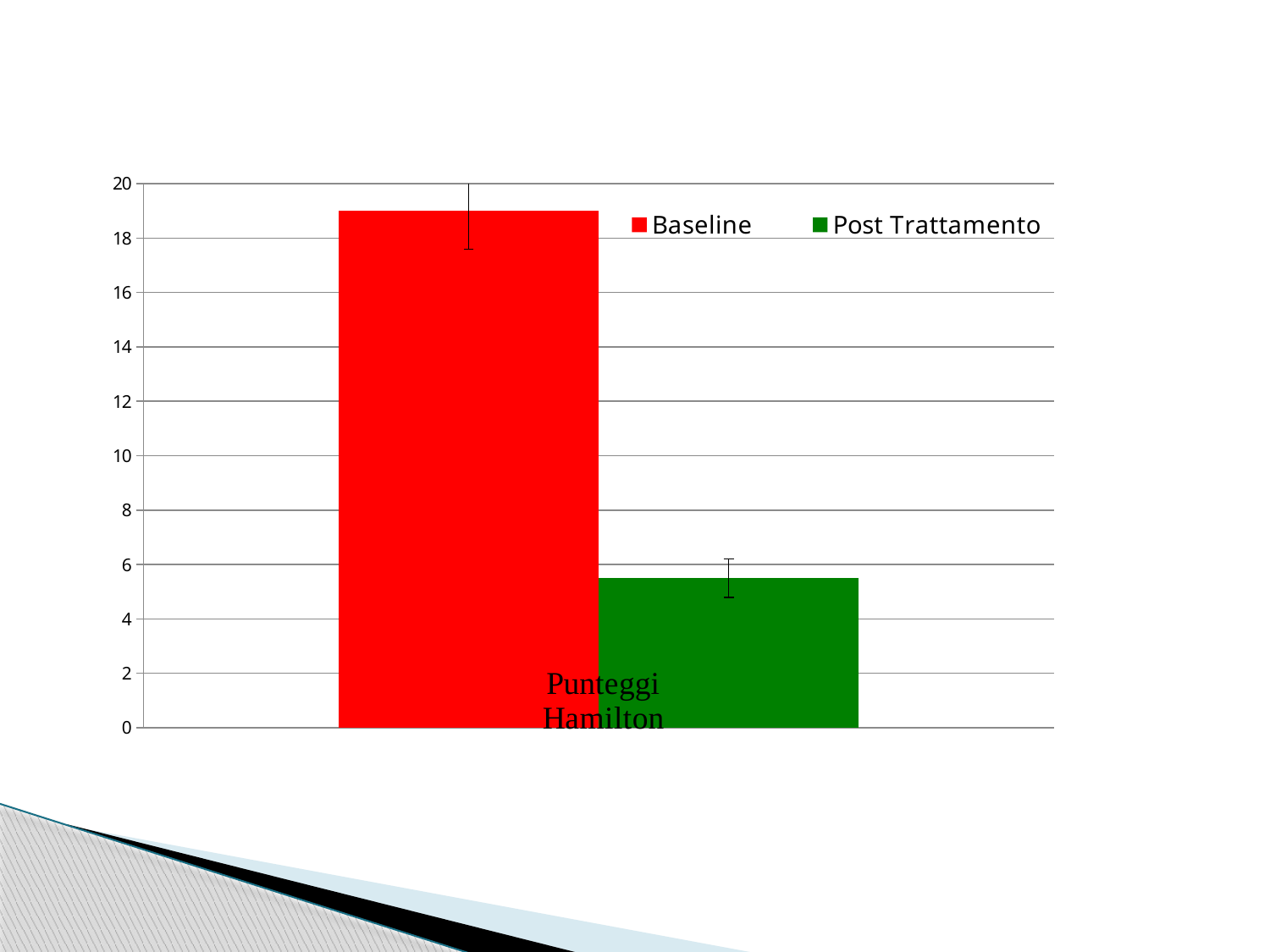
Which series has the lowest bar? Post Trattamento Is the value for Baseline greater or less than 16? greater How many series does the legend list? 2 How many categories are shown on the x axis? 1 What kind of chart is shown on the slide? bar chart Is the value for Post Trattamento greater or less than 4? greater Which series has the highest bar? Baseline Is the value for Baseline greater or less than 20? less Which series has the higher value, Baseline or Post Trattamento? Baseline What is the label of the category on the x axis? Punteggi Hamilton What colour is the Baseline bar? red